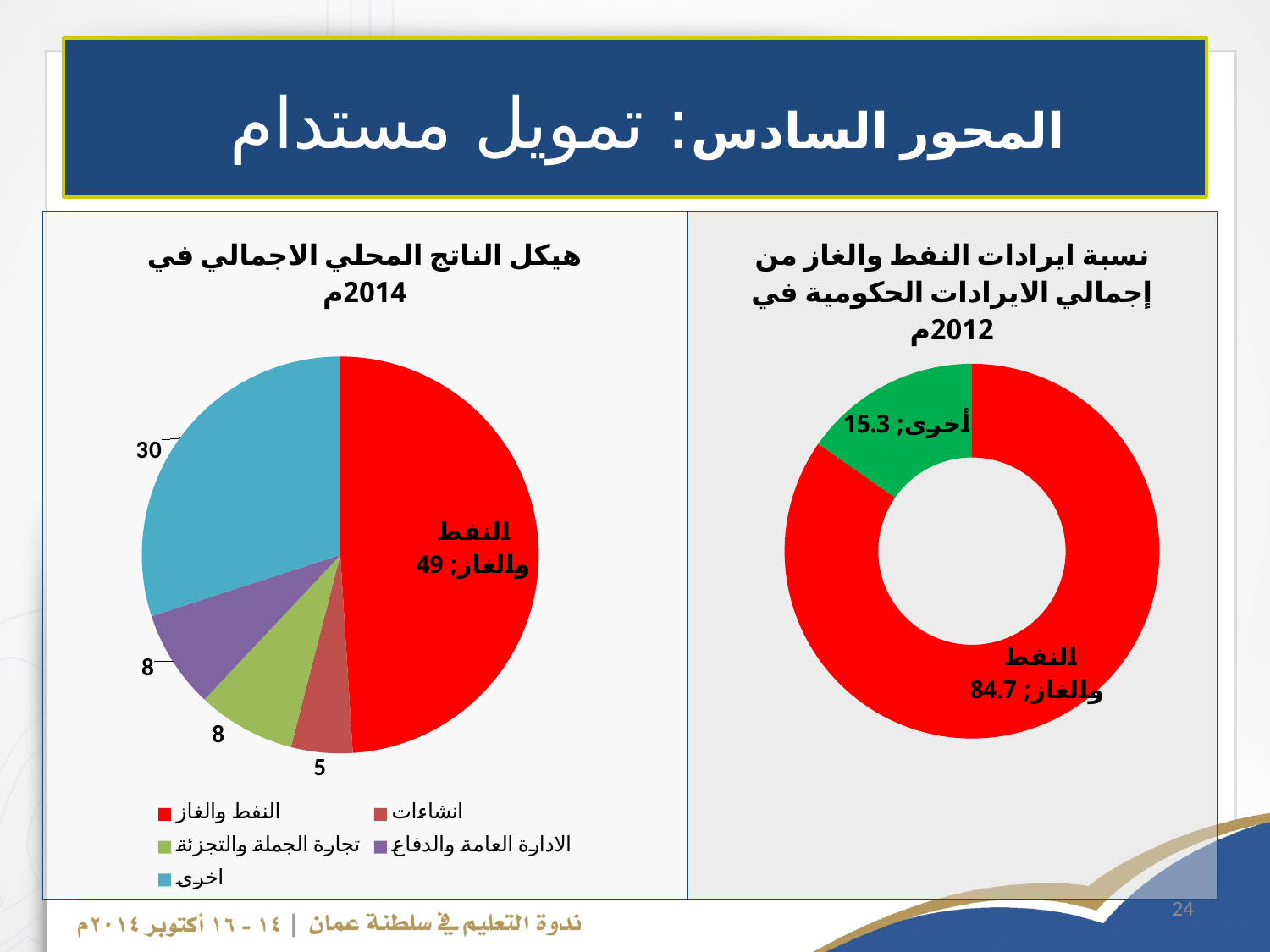
In the left chart (هيكل الناتج المحلي الاجمالي في 2014م), which category has the smallest slice? انشاءات What type of chart is the right chart (نسبة ايرادات النفط والغاز من إجمالي الايرادات الحكومية في 2012م)? Doughnut chart How many categories does the legend of the left chart (هيكل الناتج المحلي الاجمالي في 2014م) list? 5 What type of chart is the left chart (هيكل الناتج المحلي الاجمالي في 2014م)? Pie chart In the right chart (نسبة ايرادات النفط والغاز من إجمالي الايرادات الحكومية في 2012م), what is the value for أخرى (other)? 15.3 In the right chart (نسبة ايرادات النفط والغاز من إجمالي الايرادات الحكومية في 2012م), what is the difference between the النفط والغاز value and the أخرى value? 69.4 In the left chart (هيكل الناتج المحلي الاجمالي في 2014م), what is the difference between the النفط والغاز value and the أخرى value? 19 In the right chart (نسبة ايرادات النفط والغاز من إجمالي الايرادات الحكومية في 2012م), what is the value for النفط والغاز (oil and gas)? 84.7 In the left chart (هيكل الناتج المحلي الاجمالي في 2014م), which category has the largest slice? النفط والغاز In the left chart (هيكل الناتج المحلي الاجمالي في 2014م), what is the value for انشاءات (construction)? 5 In the left chart (هيكل الناتج المحلي الاجمالي في 2014م), what is the value for the أخرى (other) slice? 30 In the left chart (هيكل الناتج المحلي الاجمالي في 2014م), what is the value for النفط والغاز (oil and gas)? 49